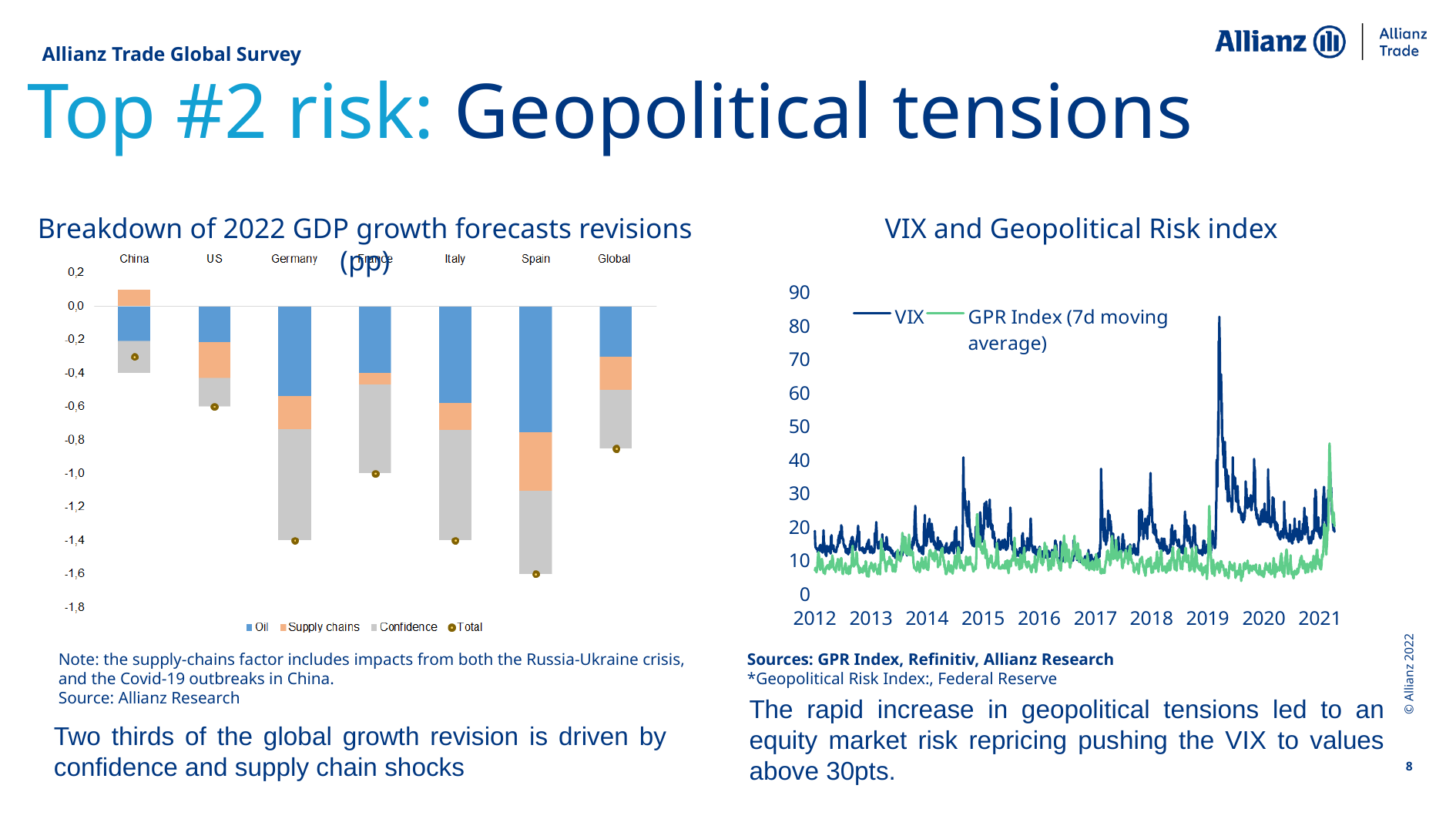
In the 'Breakdown of 2022 GDP growth forecasts revisions (pp)' chart, is the Total marker for Spain above or below -1,4 on the axis? below How many years are labelled on the x axis of the 'VIX and Geopolitical Risk index' chart? 10 What kind of chart is the 'Breakdown of 2022 GDP growth forecasts revisions (pp)' chart? Stacked bar chart How many series does the legend of the 'VIX and Geopolitical Risk index' chart list? 2 How many countries/regions are shown on the x axis of the 'Breakdown of 2022 GDP growth forecasts revisions (pp)' chart? 7 How many entries does the legend of the 'Breakdown of 2022 GDP growth forecasts revisions (pp)' chart list? 4 In the 'Breakdown of 2022 GDP growth forecasts revisions (pp)' chart, which country has the highest Total marker? China In the 'Breakdown of 2022 GDP growth forecasts revisions (pp)' chart, which series is shown in grey? Confidence In the 'Breakdown of 2022 GDP growth forecasts revisions (pp)' chart, which country has the lowest (most negative) Total marker? Spain What kind of chart is the 'VIX and Geopolitical Risk index' chart? Line chart In the 'Breakdown of 2022 GDP growth forecasts revisions (pp)' chart, is the Total marker for Germany above or below the Total marker for the US? below